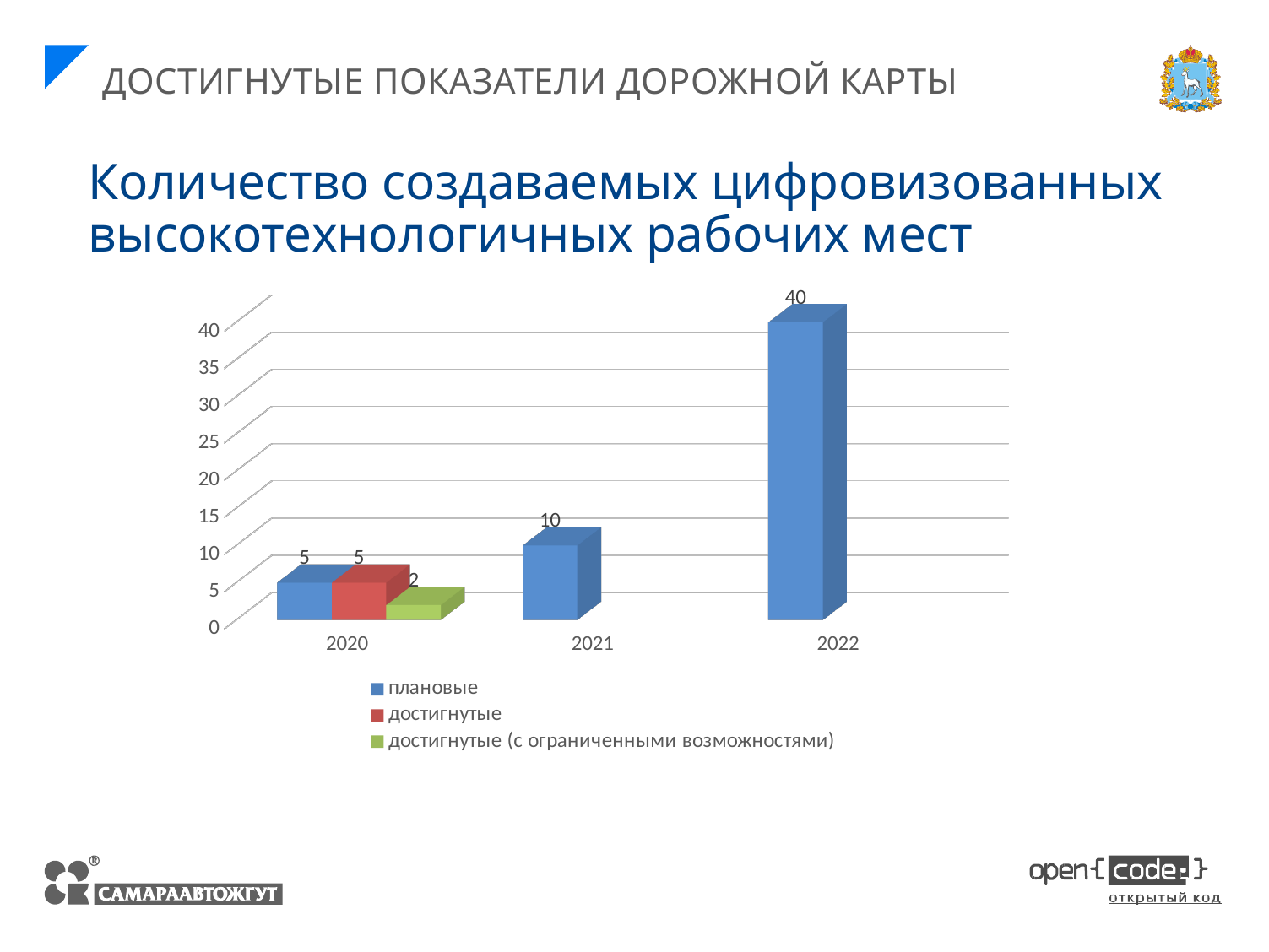
How many years are shown on the x axis? 3 What is the value of плановые for 2022? 40 Which is larger: достигнутые for 2020 or достигнутые (с ограниченными возможностями) for 2020? достигнутые Do the плановые values rise or fall from 2020 to 2022? rise What is the value of достигнутые for 2020? 5 What is the difference between the плановые values for 2022 and 2021? 30 Which year has the lowest плановые value? 2020 What is the value of плановые for 2021? 10 How many series does the legend list? 3 What kind of chart is shown on the slide? bar chart What is the value of достигнутые (с ограниченными возможностями) for 2020? 2 Which year has the highest плановые value? 2022